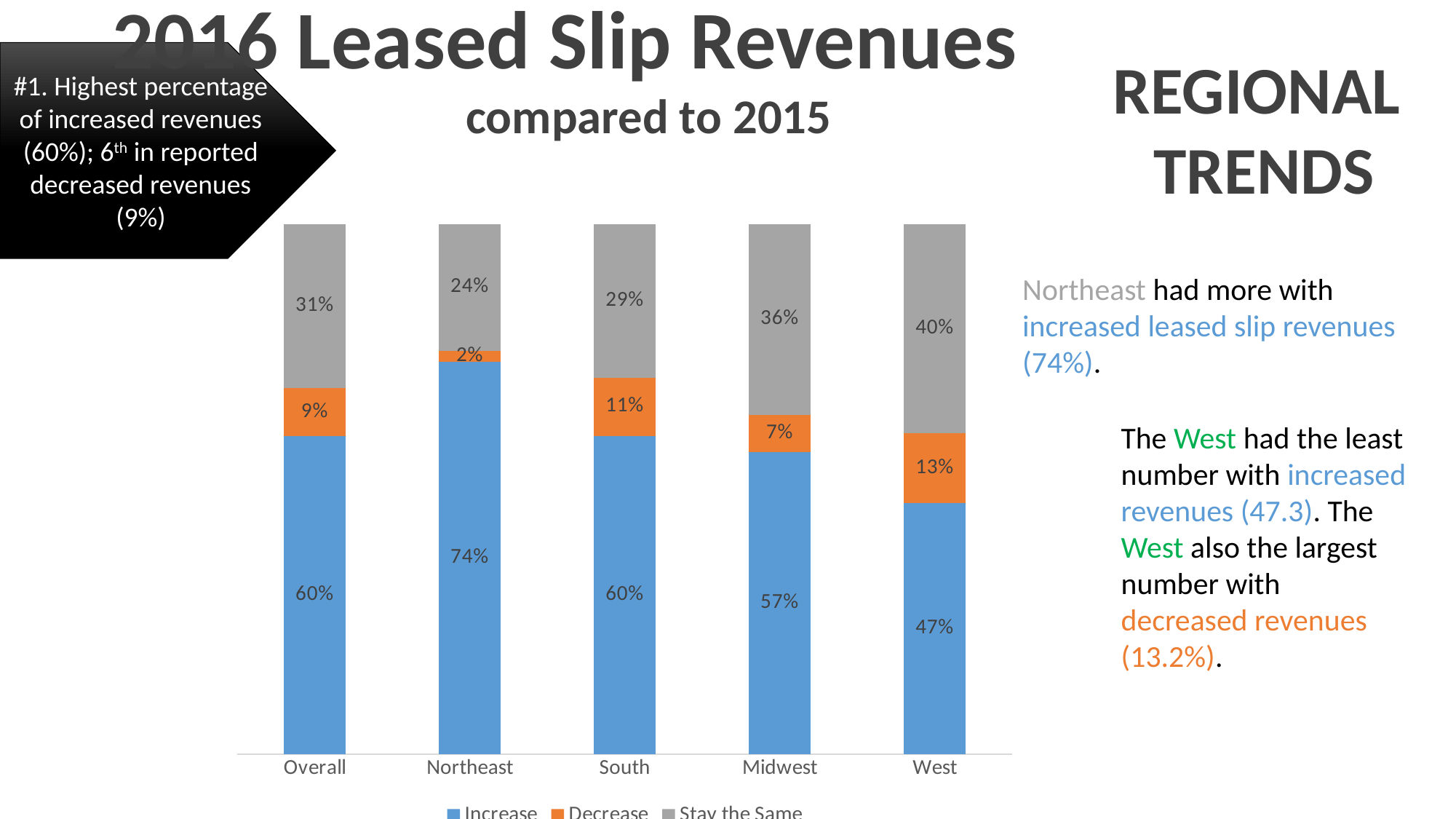
What is the difference between the Increase percentage for the Northeast and the West? 27% How many categories are shown on the x axis? 5 What percentage of Northeast respondents reported an increase in leased slip revenues? 74% Which region has the highest Stay the Same percentage? West How many series does the legend list? 3 Is the Increase percentage larger for the South or the Midwest? South What is the Decrease value for the West? 13% Which series is shown in orange? Decrease What kind of chart is shown on the slide? Stacked bar chart Which region has the highest Increase percentage? Northeast What is the Stay the Same value for the Midwest? 36% Which region has the lowest Decrease percentage? Northeast